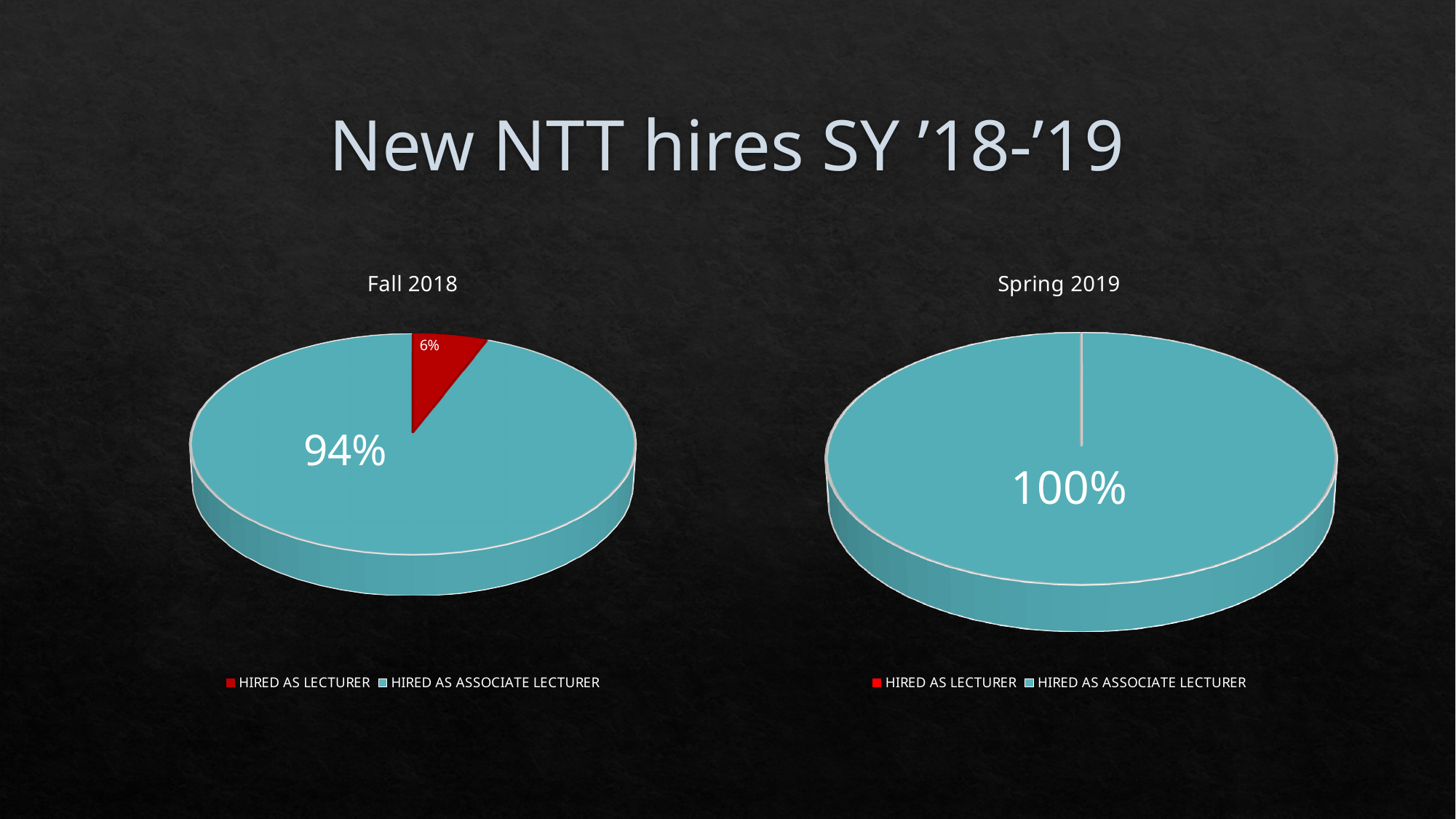
What is the title of the slide? New NTT hires SY '18-'19 How many entries does the legend of the Spring 2019 chart list? 2 What kind of chart is the Fall 2018 chart? Pie chart In the Fall 2018 chart, which category has the largest slice? Hired as associate lecturer In the Spring 2019 chart, what share of new NTT hires were hired as associate lecturer? 100% In the Fall 2018 chart, which is larger: the share hired as lecturer or the share hired as associate lecturer? Hired as associate lecturer In the Fall 2018 chart, what colour is the slice for hired as lecturer? Red In the Fall 2018 chart, what share of new NTT hires were hired as lecturer? 6% In the Fall 2018 chart, which category has the smallest slice? Hired as lecturer How many charts are shown on the slide? 2 In the Fall 2018 chart, what share of new NTT hires were hired as associate lecturer? 94% In the Fall 2018 chart, what is the difference in percentage points between the associate lecturer share and the lecturer share? 88